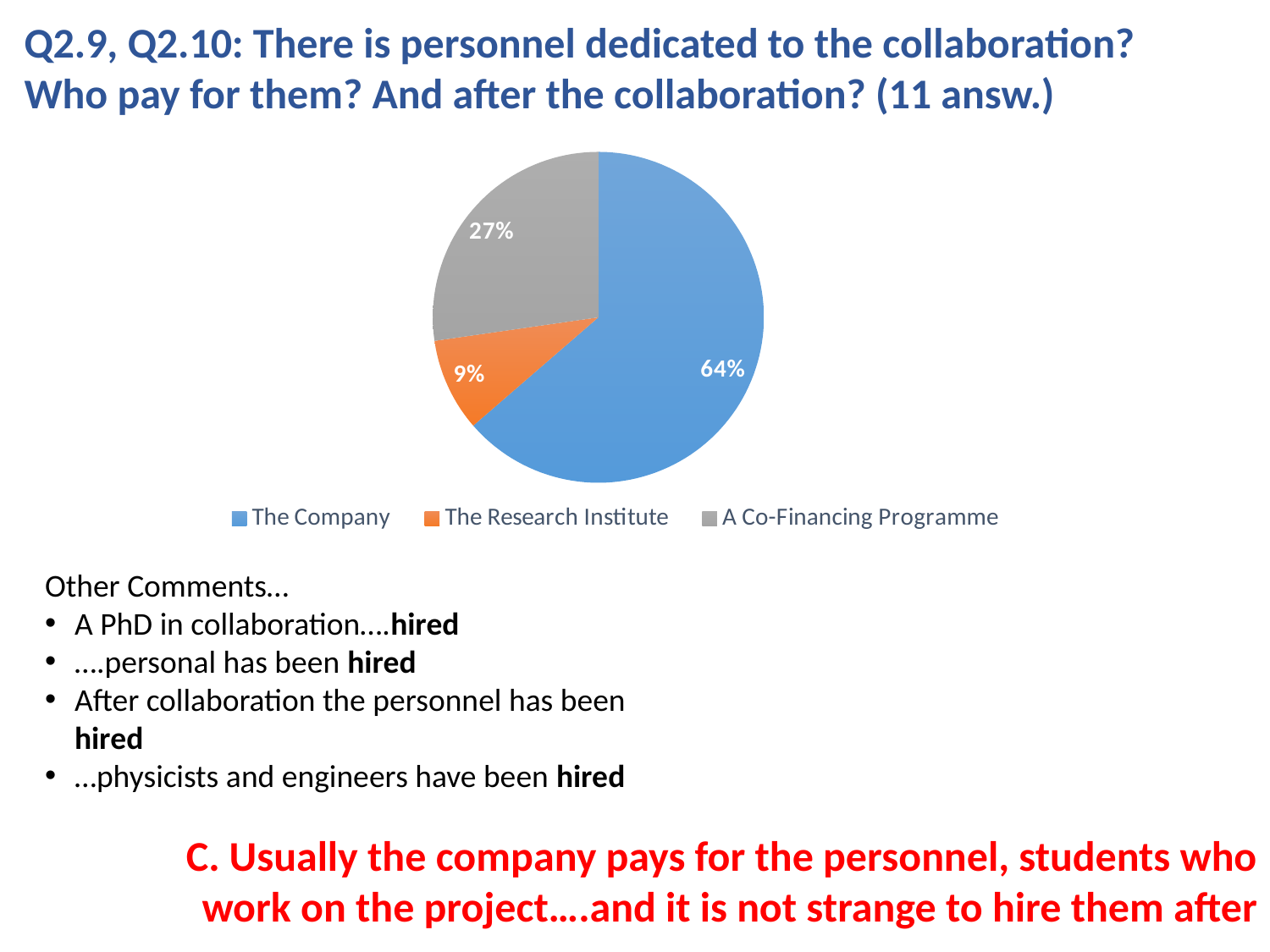
What share of the pie does The Research Institute account for? 9% Which legend entry is shown in grey? A Co-Financing Programme What share of the pie does The Company account for? 64% What kind of chart is shown on the slide? Pie chart Which category has the smallest slice of the pie? The Research Institute How many slices does the pie chart have? 3 Which is larger, the slice for A Co-Financing Programme or the slice for The Research Institute? A Co-Financing Programme What colour is the slice for The Research Institute? Orange What is the difference in percentage points between A Co-Financing Programme and The Research Institute? 18 What share of the pie does A Co-Financing Programme account for? 27% What is the difference in percentage points between The Company and A Co-Financing Programme? 37 Which category has the largest slice of the pie? The Company